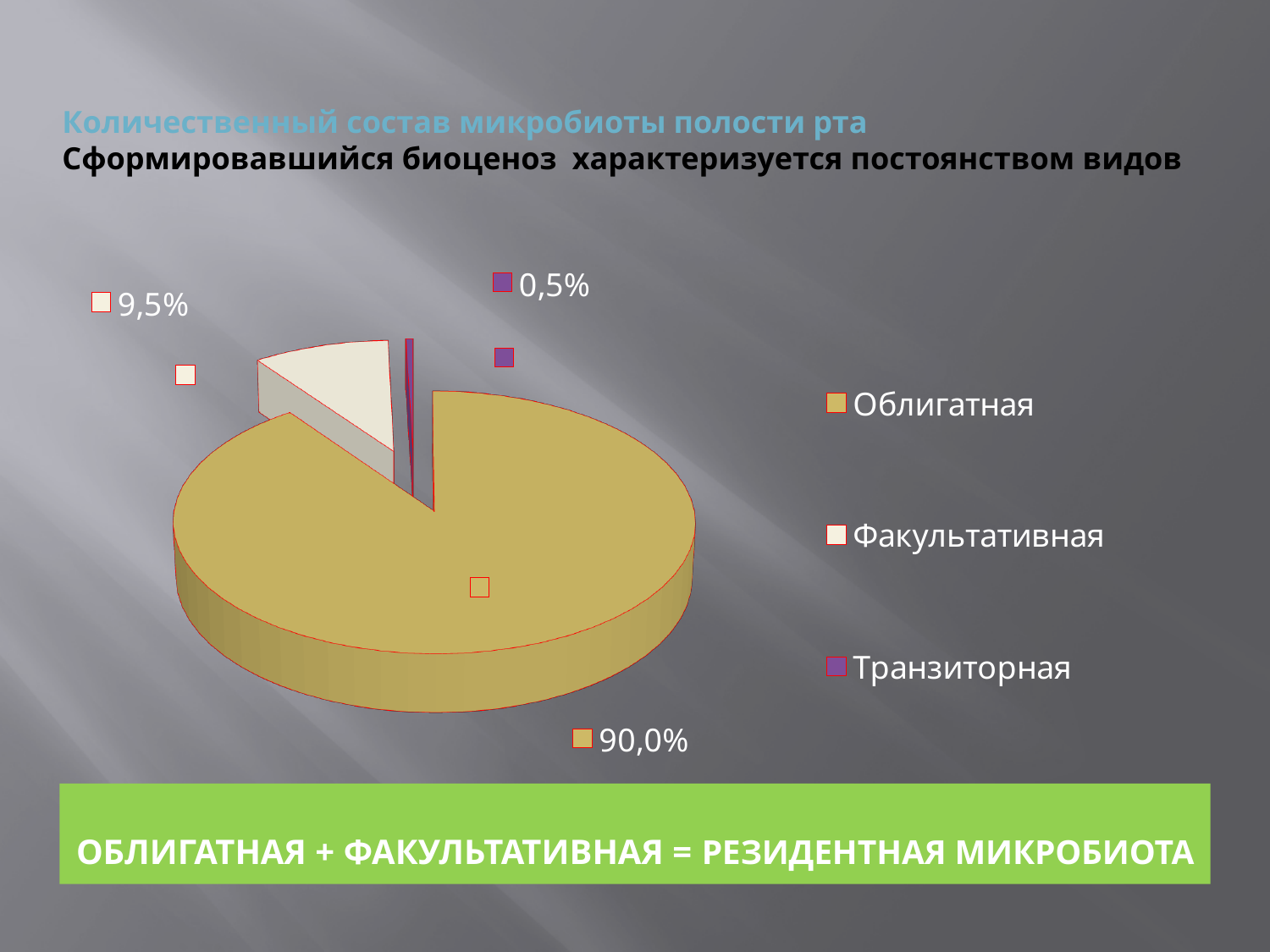
Which is larger, the value for Факультативная or the value for Транзиторная? Факультативная What is the value for Облигатная? 90,0% What is the value for Транзиторная? 0,5% How many slices does the pie chart have? 3 What colour is the slice for Облигатная? gold/tan Which category has the smallest slice of the pie? Транзиторная Which category has the largest slice of the pie? Облигатная How many entries does the legend list? 3 What is the difference between the values for Факультативная and Транзиторная? 9,0% What is the value for Факультативная? 9,5% What kind of chart is shown on the slide? pie chart What is the difference between the values for Облигатная and Факультативная? 80,5%